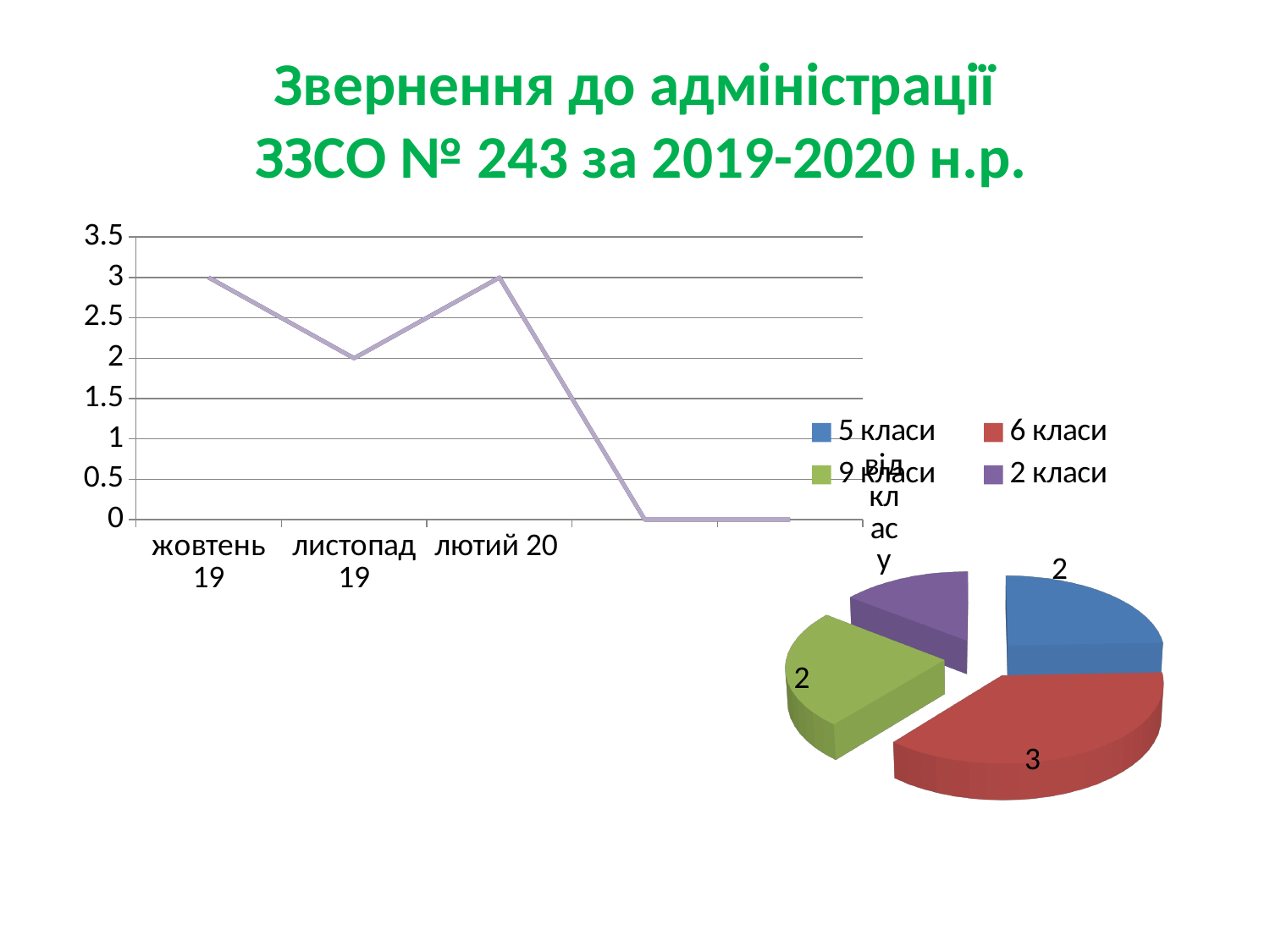
What kind of chart is the chart on the left of the slide? line chart How many entries does the legend of the pie chart on the right list? 4 In the line chart on the left, among the three labelled months, which has the lowest value? листопад 19 In the line chart on the left, what is the difference between the values for жовтень 19 and листопад 19? 1 In the line chart on the left, what is the value for листопад 19? 2 In the line chart on the left, which is larger: the value for листопад 19 or the value for лютий 20? лютий 20 In the line chart on the left, what is the value for жовтень 19? 3 In the pie chart on the right, what is the value for 6 класи? 3 In the line chart on the left, what is the value for лютий 20? 3 What kind of chart is the chart on the right of the slide? pie chart In the pie chart on the right, what is the value for 5 класи? 2 In the pie chart on the right, which category has the largest slice? 6 класи